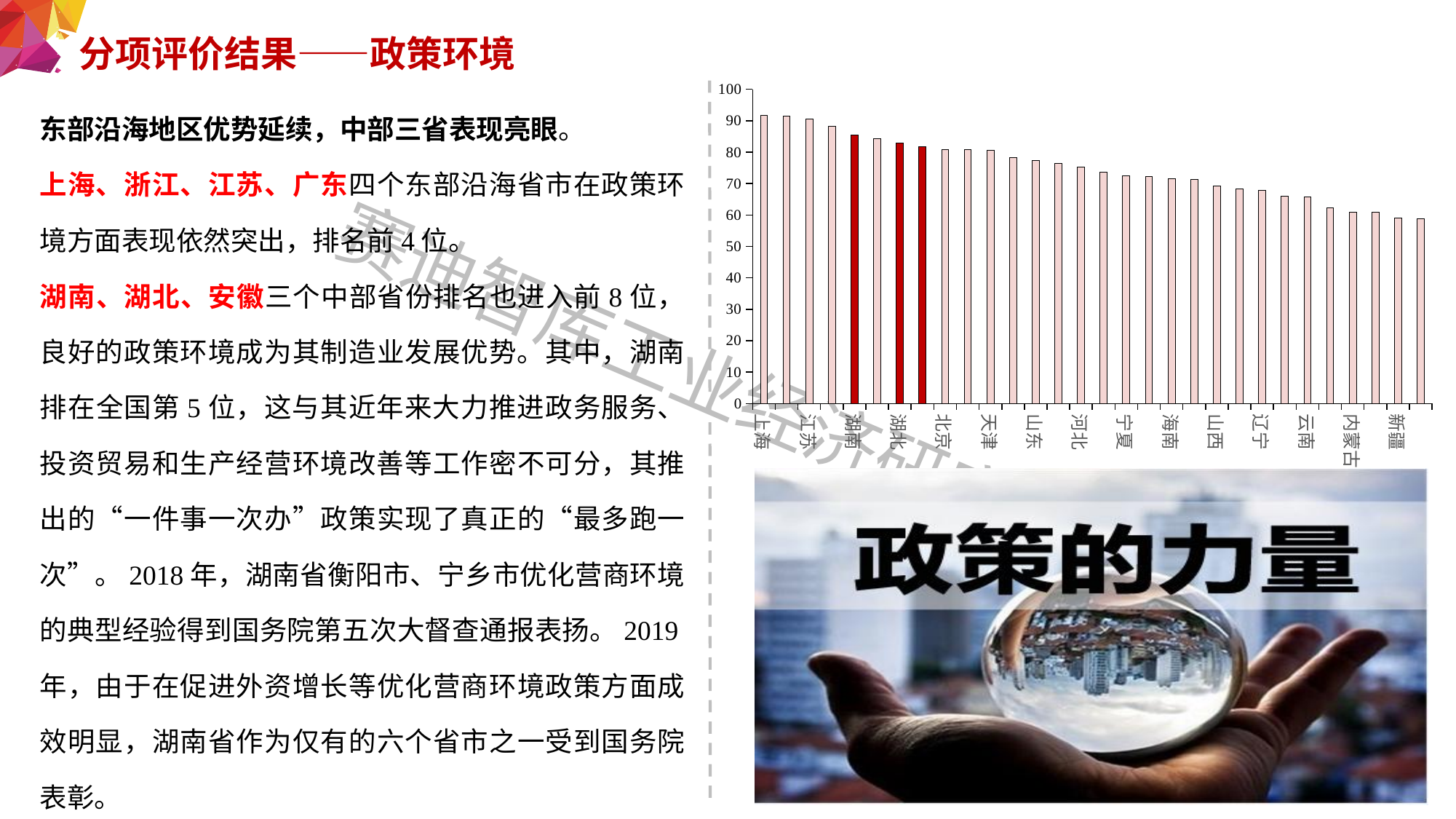
Is the value for 北京 greater or less than 70? greater Is the value for 新疆 greater or less than 70? less Is the value for 云南 greater or less than 70? less How many bars are plotted in the chart? 30 Which has the larger value, 湖南 or 北京? 湖南 Which has the larger value, 江苏 or 山东? 江苏 Do the bar values rise or fall from left to right along the x axis? fall What kind of chart is shown on the slide? bar chart How many bars in the chart are highlighted in dark red? 3